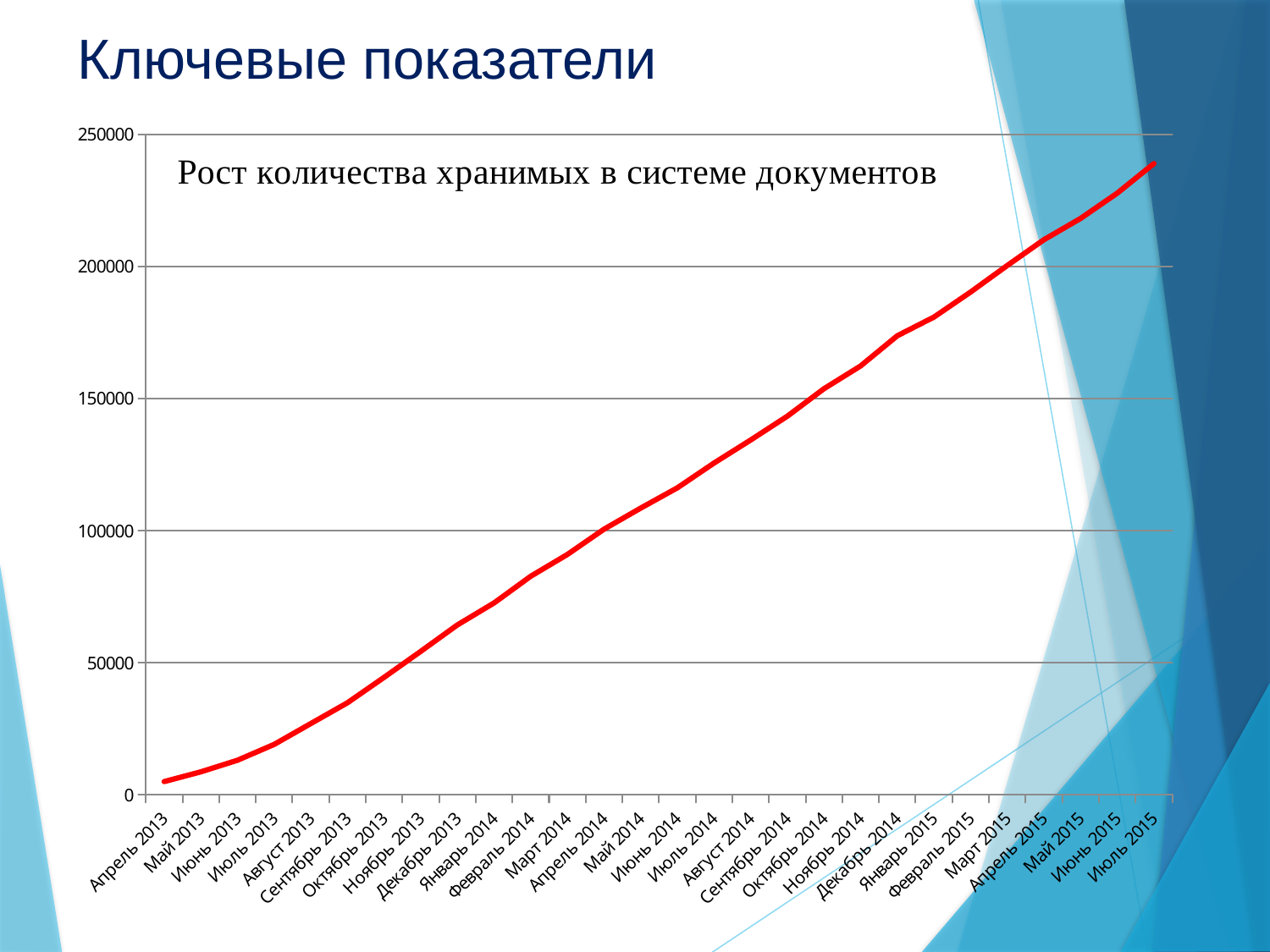
What is the title of the chart? Рост количества хранимых в системе документов Is the value for Декабрь 2014 greater or less than 150000? greater Is the value for Январь 2014 greater or less than 100000? less How many months (data points) are plotted along the x axis? 28 Is the value for Июль 2015 greater or less than 200000? greater What kind of chart is shown on the slide? line chart Which is larger, the value for Июль 2013 or the value for Июль 2014? Июль 2014 What colour is the plotted line? red Do the values rise or fall along the x axis from Апрель 2013 to Июль 2015? rise Which month has the highest value on the chart? Июль 2015 Which month has the lowest value on the chart? Апрель 2013